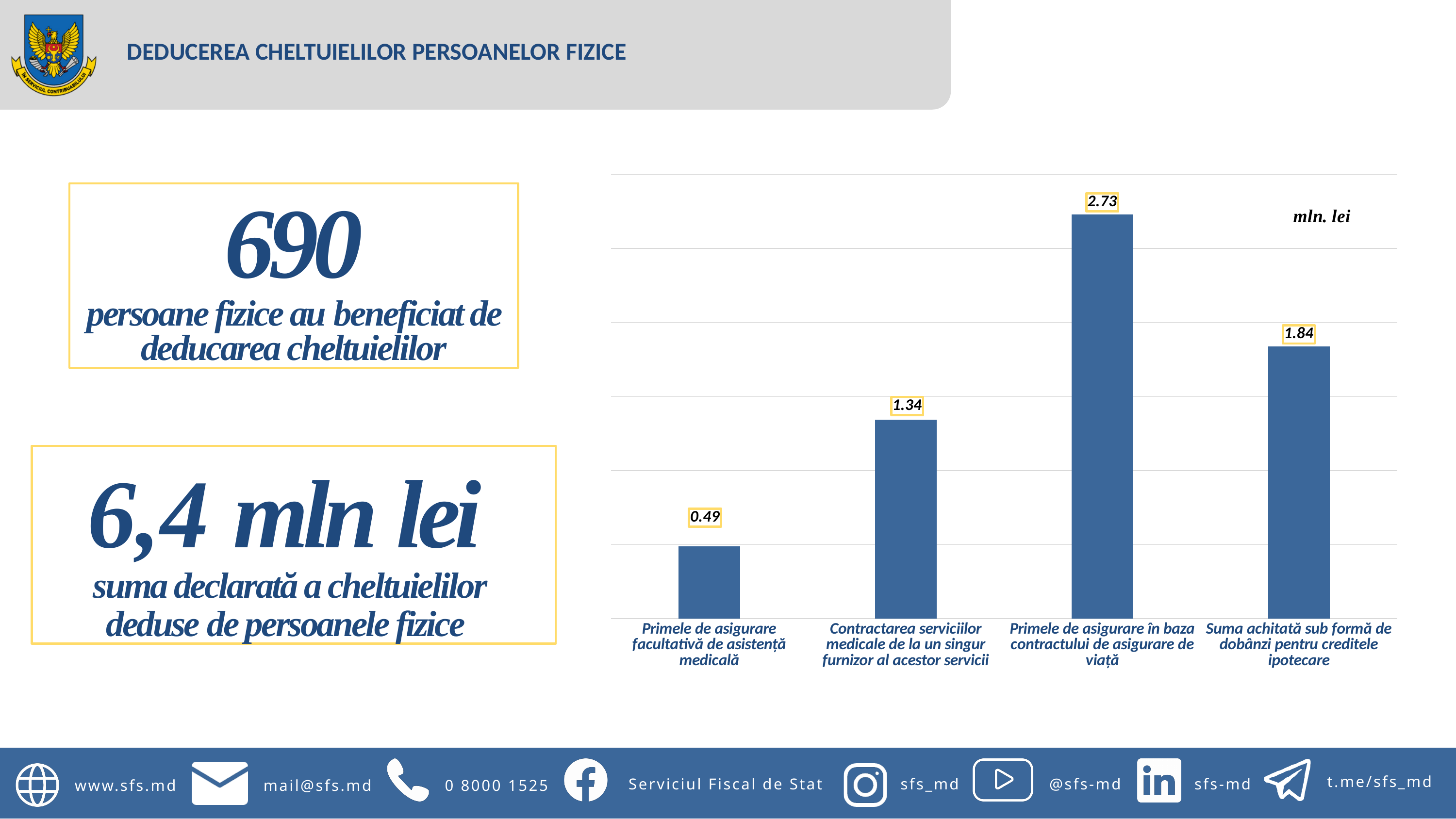
What is the value for "Contractarea serviciilor medicale de la un singur furnizor al acestor servicii"? 1.34 Which is larger: the value for "Suma achitată sub formă de dobânzi pentru creditele ipotecare" or the value for "Contractarea serviciilor medicale de la un singur furnizor al acestor servicii"? Suma achitată sub formă de dobânzi pentru creditele ipotecare What is the difference between the values for "Primele de asigurare în baza contractului de asigurare de viață" and "Suma achitată sub formă de dobânzi pentru creditele ipotecare"? 0.89 What is the value for "Primele de asigurare în baza contractului de asigurare de viață"? 2.73 What is the value for "Suma achitată sub formă de dobânzi pentru creditele ipotecare"? 1.84 Which category has the lowest value? Primele de asigurare facultativă de asistență medicală How many categories are shown in the chart? 4 What unit is indicated on the chart? mln. lei What is the difference between the values for "Contractarea serviciilor medicale de la un singur furnizor al acestor servicii" and "Primele de asigurare facultativă de asistență medicală"? 0.85 What kind of chart is shown on the slide? Bar chart Which category has the highest value? Primele de asigurare în baza contractului de asigurare de viață What is the value for "Primele de asigurare facultativă de asistență medicală"? 0.49